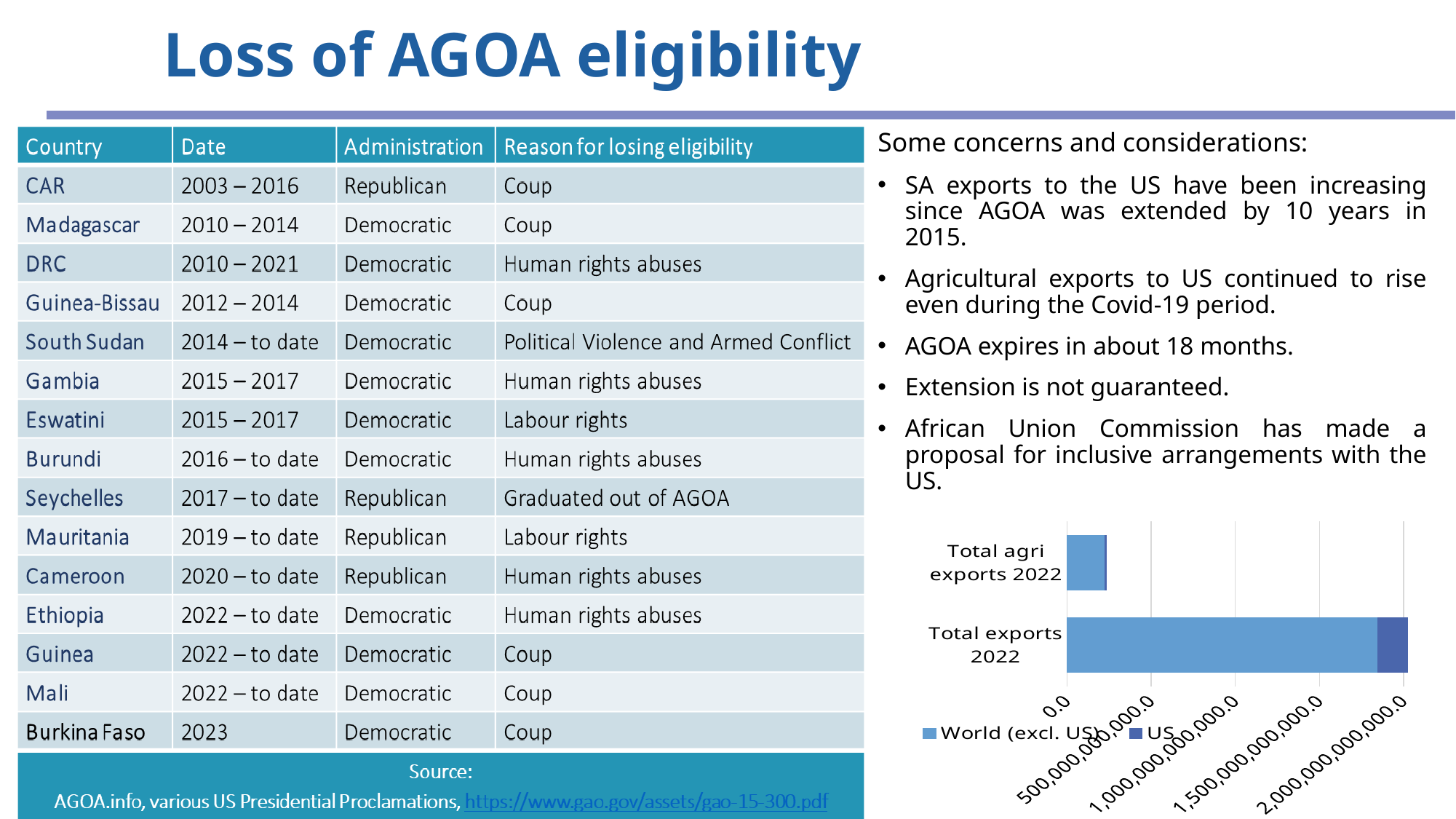
Is the World (excl. US) value for Total exports 2022 greater or less than 1,000,000,000,000.0? greater Is the total value for Total exports 2022 greater or less than 1,500,000,000,000.0? greater How many series does the legend of the bar chart list? 2 Which category has the lowest total value on the bar chart? Total agri exports 2022 Which category has the longer bar on the chart, Total agri exports 2022 or Total exports 2022? Total exports 2022 Which category has the highest total value on the bar chart? Total exports 2022 Which series is shown in the darker blue colour on the chart? US Is the value for Total agri exports 2022 greater or less than 500,000,000,000.0? less How many categories are plotted on the bar chart? 2 What kind of chart is shown on the slide? Bar chart What are the two series named in the chart legend? World (excl. US) and US